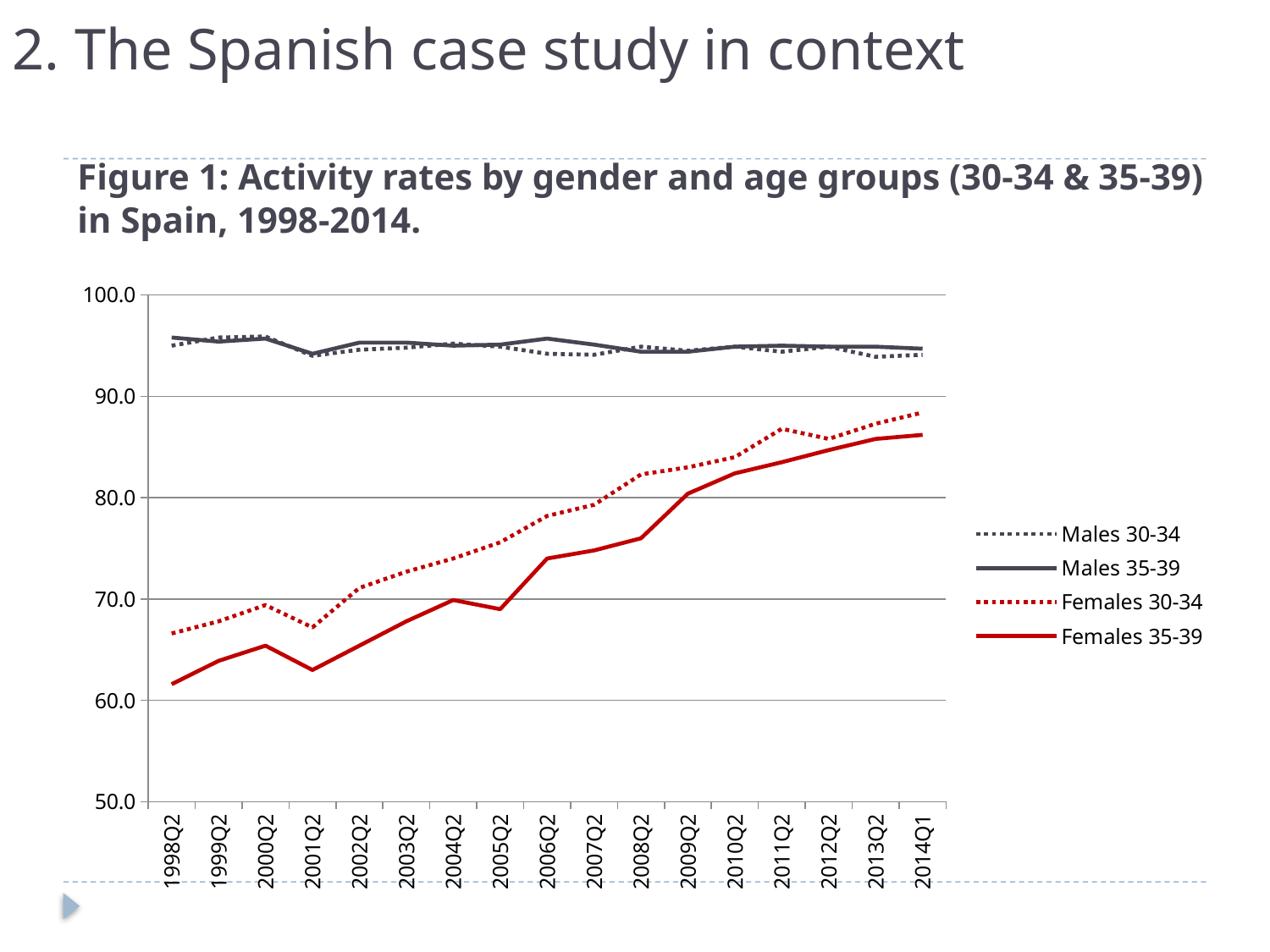
In 1998Q2, which is larger: the value for Females 30-34 or Females 35-39? Females 30-34 Is the value for Females 35-39 in 1998Q2 greater or less than 70.0? less Is the value for Males 35-39 in 2006Q2 greater or less than 90.0? greater What is the title of the figure on the slide? Figure 1: Activity rates by gender and age groups (30-34 & 35-39) in Spain, 1998-2014. Does the Females 30-34 series generally rise or fall across the period shown? Rise Which series has the lowest value in 1998Q2? Females 35-39 What kind of chart is shown in Figure 1? Line chart How many series does the legend list? 4 Does the Females 35-39 series generally rise or fall from 1998Q2 to 2014Q1? Rise Is the value for Females 35-39 in 2005Q2 greater or less than 70.0? less How many time points are labelled on the x axis? 17